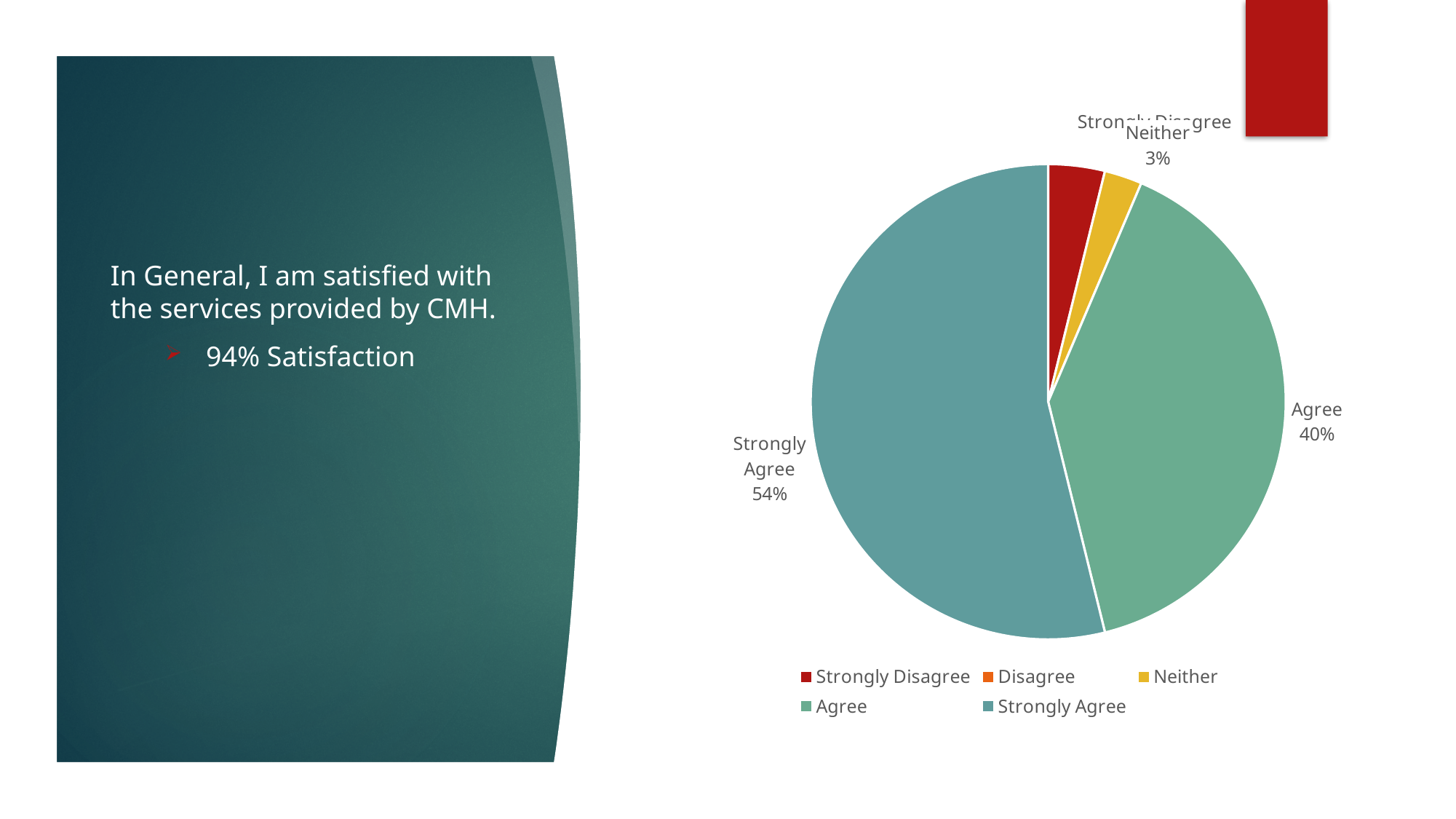
What colour is the Neither slice in the pie chart? Yellow What is the combined share of the Agree and Strongly Agree slices? 94% Which response category has the largest slice of the pie chart? Strongly Agree What kind of chart is shown on the slide? Pie chart What colour is the Strongly Disagree slice in the pie chart? Red What percentage of the pie chart is labelled Neither? 3% What is the difference in percentage points between the Strongly Agree and Agree slices? 14% How many categories does the chart legend list? 5 Which slice is larger, Neither or Agree? Agree What percentage of the pie chart is labelled Agree? 40% Which slice is larger, Agree or Strongly Agree? Strongly Agree What percentage of the pie chart is labelled Strongly Agree? 54%